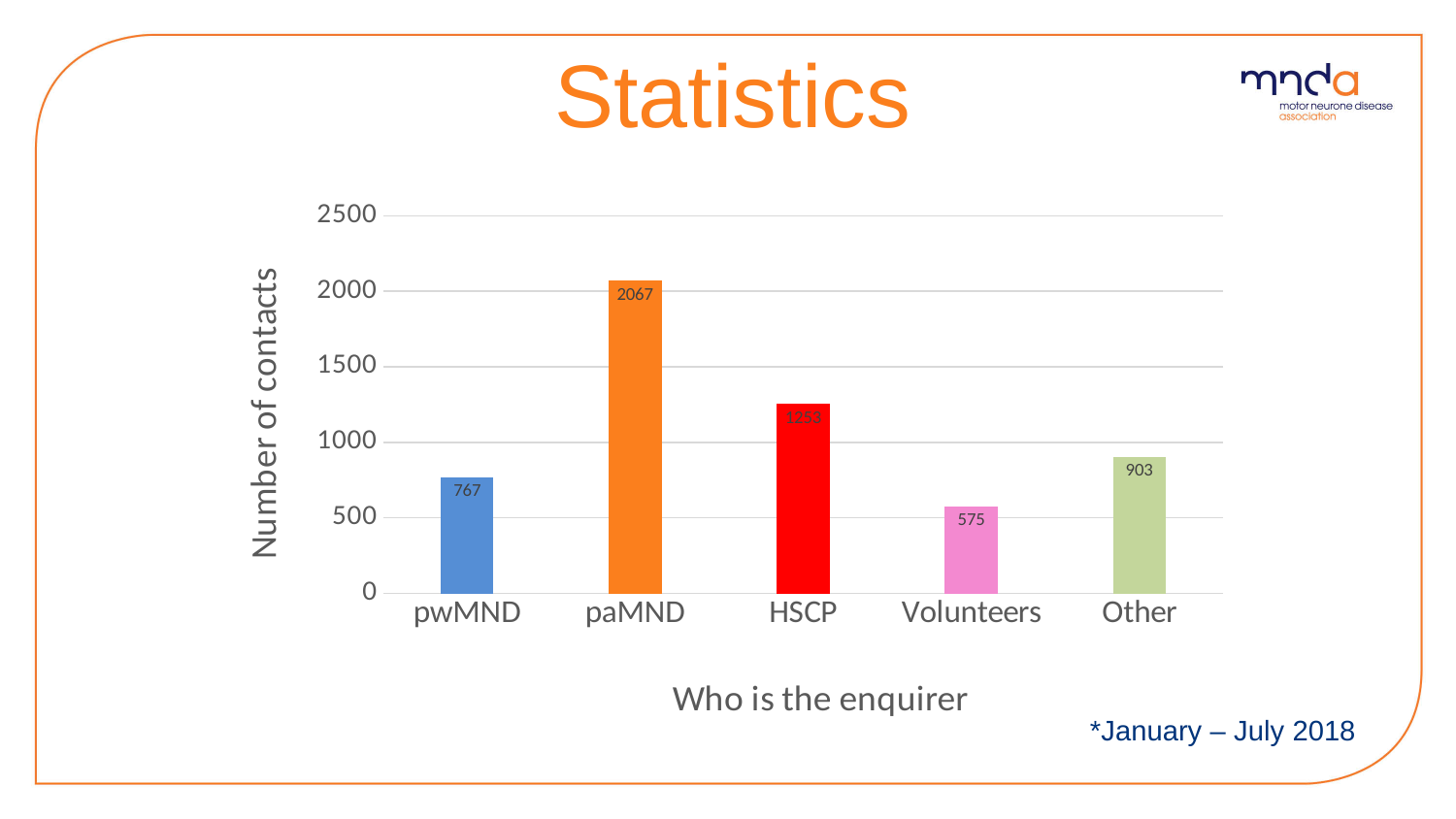
Which enquirer category has the lowest number of contacts? Volunteers What is the number of contacts for Other? 903 Which has more contacts, Other or pwMND? Other What is the number of contacts for Volunteers? 575 What is the difference in number of contacts between paMND and pwMND? 1300 What is the label of the x axis? Who is the enquirer What is the number of contacts for paMND? 2067 Is the value for HSCP greater or less than 1000? greater What kind of chart is shown on the slide? Bar chart Which enquirer category has the highest number of contacts? paMND How many enquirer categories are shown on the x axis? 5 What is the number of contacts for pwMND? 767